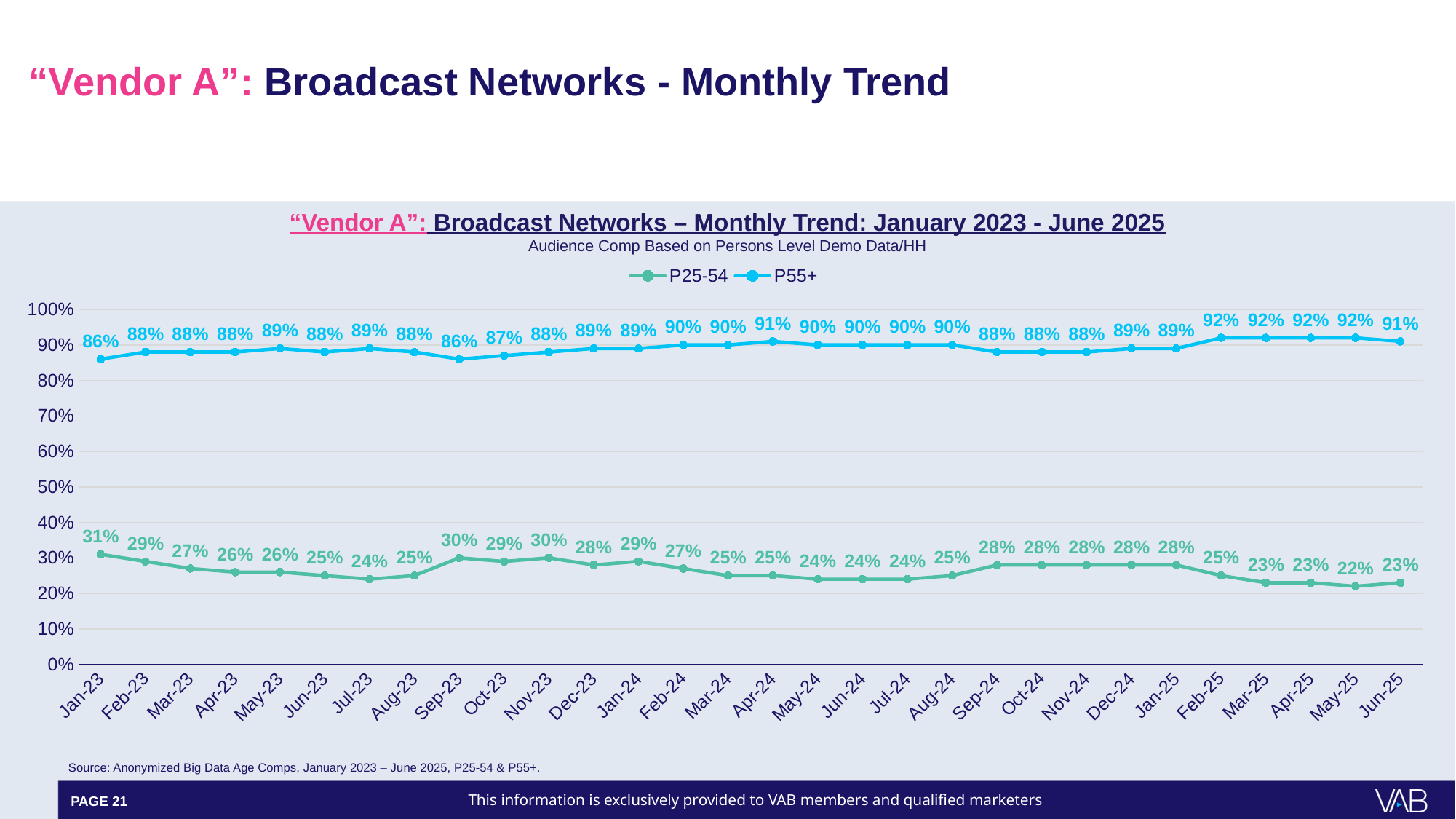
In which month is the P25-54 value highest? Jan-23 What is the difference between the P25-54 value in Jan-23 and in Jun-25? 8% What kind of chart is shown on the slide? line chart In which month is the P25-54 value lowest? May-25 Is the P55+ value for Feb-25 greater or less than 90%? greater How many months are plotted on the x axis? 30 What is the P55+ value for Jun-25? 91% What is the difference between the P55+ and P25-54 values in Jan-23? 55% How many series does the legend list? 2 Which is larger, the P25-54 value in Sep-24 or in Feb-25? Sep-24 What is the P55+ value for Apr-24? 91% What is the P25-54 value for Sep-23? 30%